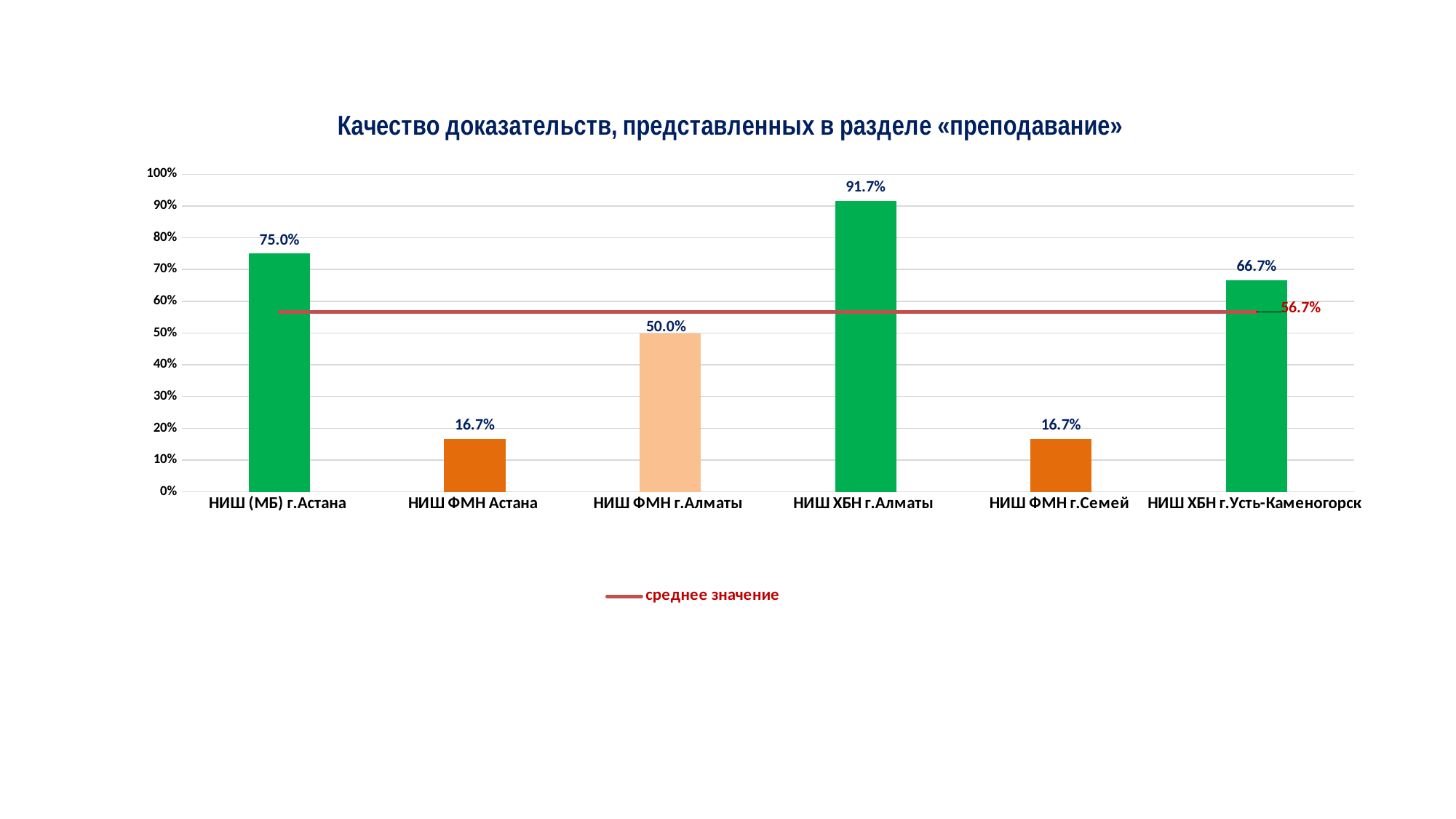
What is the value for НИШ ХБН г.Алматы? 91.7% What is the value for НИШ (МБ) г.Астана? 75.0% How many categories are shown on the x axis? 6 Which is larger, the value for НИШ (МБ) г.Астана or the value for НИШ ХБН г.Усть-Каменогорск? НИШ (МБ) г.Астана What is the value of the average line (среднее значение) shown on the chart? 56.7% What kind of chart is this? bar chart What is the title of the chart? Качество доказательств, представленных в разделе «преподавание» What is the difference between the values for НИШ ХБН г.Алматы and НИШ ФМН г.Алматы? 41.7% What is the value for НИШ ФМН г.Алматы? 50.0% Which category has the highest value? НИШ ХБН г.Алматы What is the value for НИШ ХБН г.Усть-Каменогорск? 66.7% Is the value for НИШ ФМН г.Семей greater or less than 20%? less